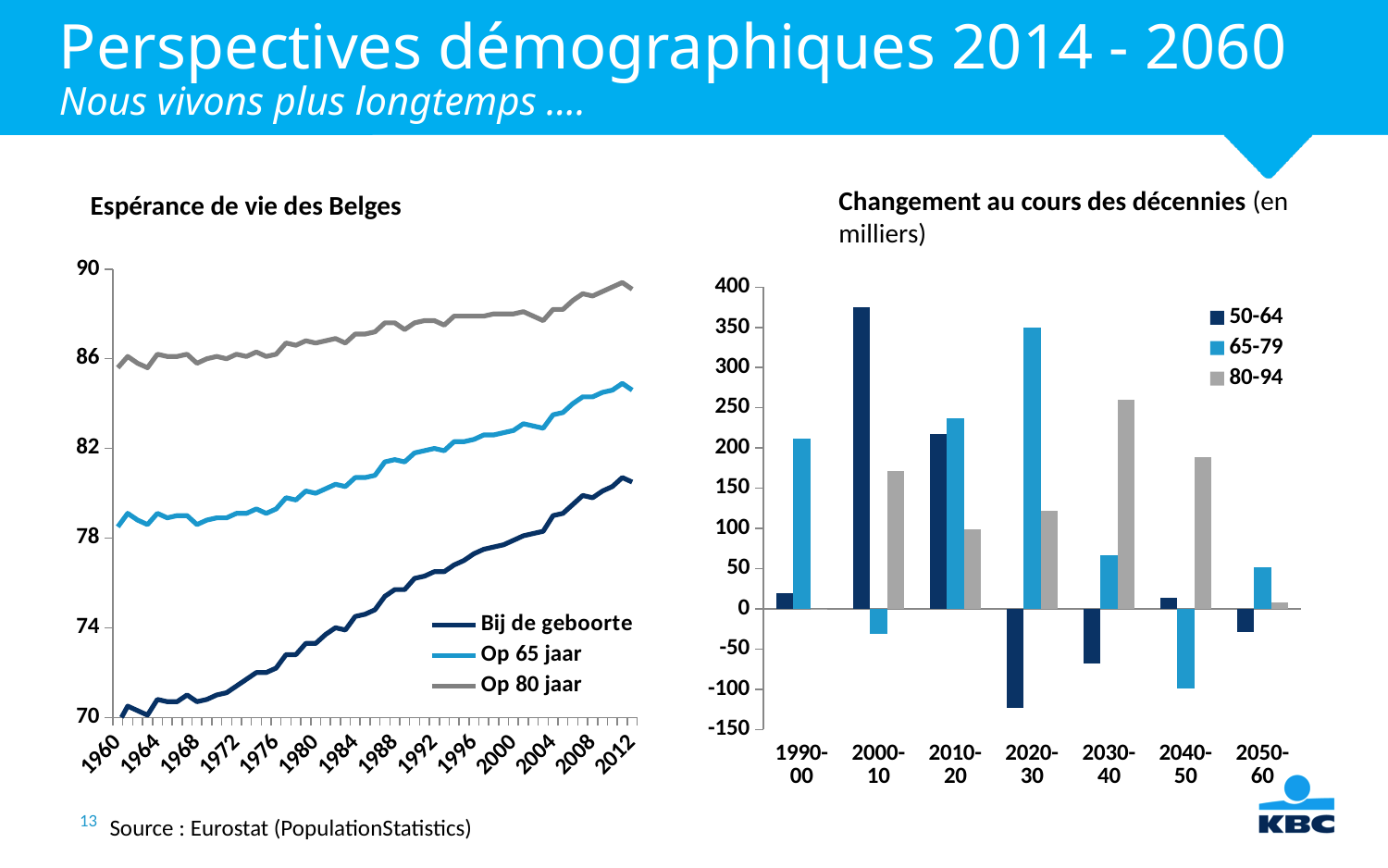
In the 'Changement au cours des décennies' chart, in which decade is the 50-64 series lowest? 2020-30 In the 'Changement au cours des décennies' chart, in which decade is the 80-94 series highest? 2030-40 In the 'Changement au cours des décennies' chart, in which decade is the 50-64 series highest? 2000-10 How many series does the legend of the 'Changement au cours des décennies' chart list? 3 What kind of chart is the 'Espérance de vie des Belges' chart on the left? line chart How many decade categories are shown on the x axis of the 'Changement au cours des décennies' chart? 7 What kind of chart is the 'Changement au cours des décennies' chart on the right? bar chart In the 'Changement au cours des décennies' chart, in which decade is the 65-79 series highest? 2020-30 In the 'Changement au cours des décennies' chart, in 2030-40, which series has the larger value: 80-94 or 65-79? 80-94 In the 'Espérance de vie des Belges' chart, is the value of 'Op 65 jaar' in 2012 greater or less than 82? greater In the 'Espérance de vie des Belges' chart, does the 'Bij de geboorte' line rise or fall from 1960 to 2012? rise In the 'Changement au cours des décennies' chart, is the value for 50-64 in 2000-10 greater or less than 350? greater